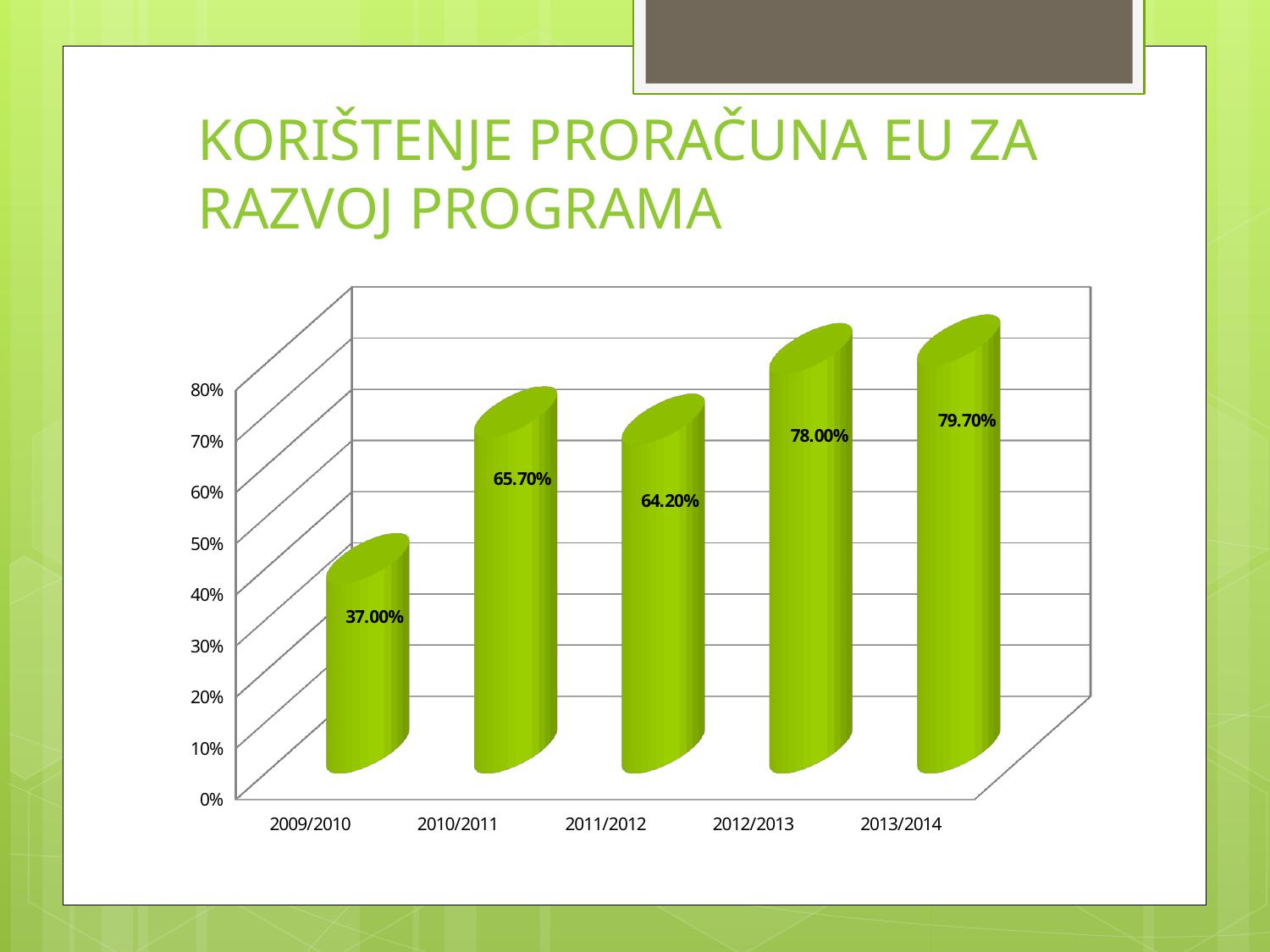
What is the title of the slide containing the chart? KORIŠTENJE PRORAČUNA EU ZA RAZVOJ PROGRAMA What kind of chart is shown on the slide? bar chart How many categories are shown on the x axis? 5 What is the value for 2011/2012? 64.20% Which year has the lowest value? 2009/2010 Which year has the highest value? 2013/2014 What is the value for 2009/2010? 37.00% What is the difference between the values for 2010/2011 and 2011/2012? 1.50% Is the value for 2012/2013 greater or less than 70%? greater Which is larger, the value for 2010/2011 or the value for 2011/2012? 2010/2011 What is the value for 2013/2014? 79.70% What is the difference between the values for 2012/2013 and 2009/2010? 41.00%